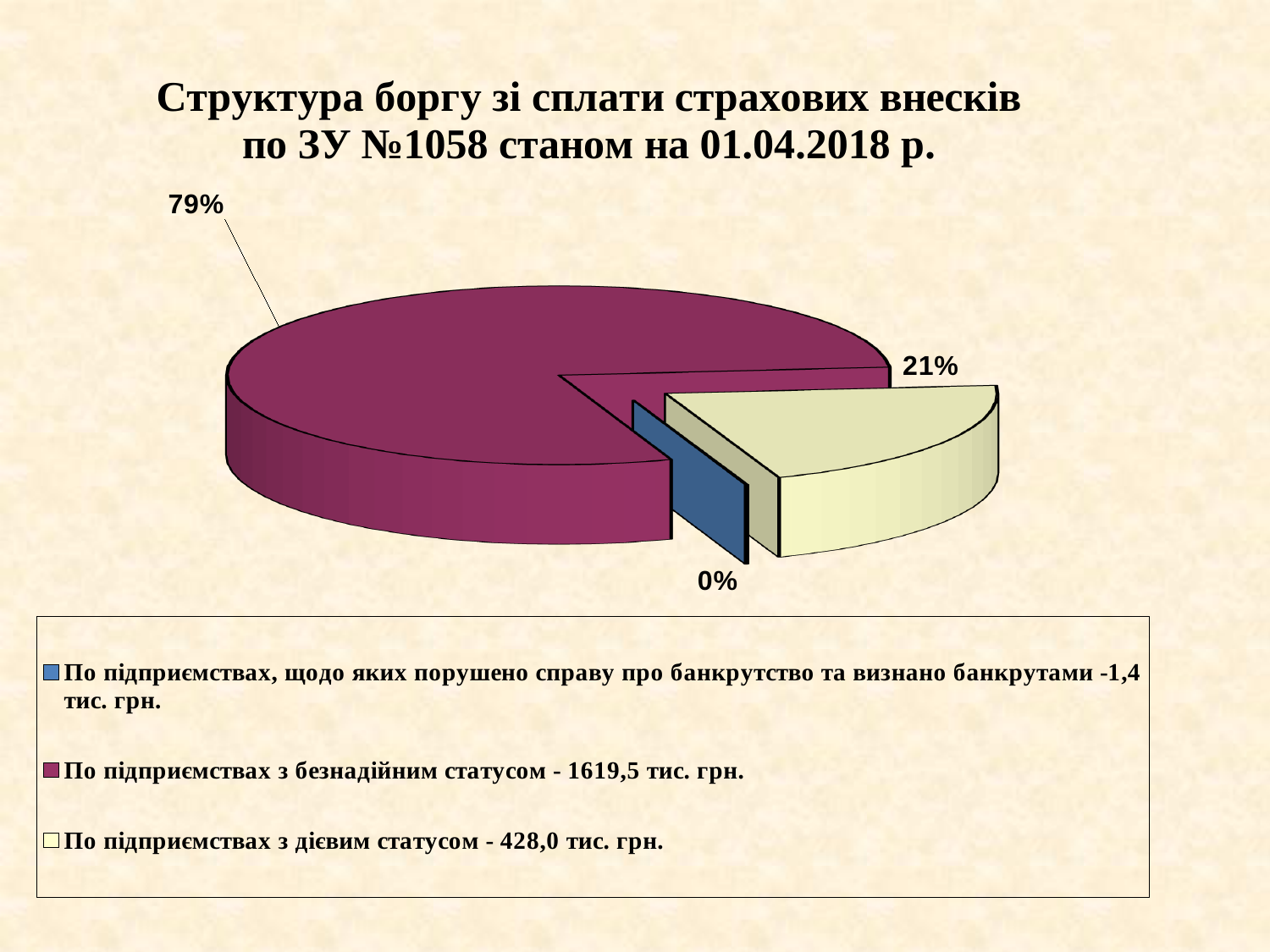
Which category has the largest share of the pie? По підприємствах з безнадійним статусом What is the difference in percentage points between the 79% slice and the 21% slice? 58 percentage points What date is given in the chart title? 01.04.2018 р. How many slices does the pie chart have? 3 Which category has the smallest share of the pie? По підприємствах, щодо яких порушено справу про банкрутство та визнано банкрутами What kind of chart is shown on the slide? Pie chart Which is larger: the share for enterprises with active status or the share for enterprises with hopeless status? Enterprises with hopeless status (безнадійним статусом) What share of the pie is labelled for enterprises with hopeless status (безнадійним статусом)? 79% According to the legend, what is the debt amount for enterprises with hopeless status? 1619,5 тис. грн. What share of the pie is labelled for enterprises in bankruptcy proceedings or declared bankrupt? 0% According to the legend, what is the debt amount for enterprises with active status? 428,0 тис. грн. What share of the pie is labelled for enterprises with active status (дієвим статусом)? 21%